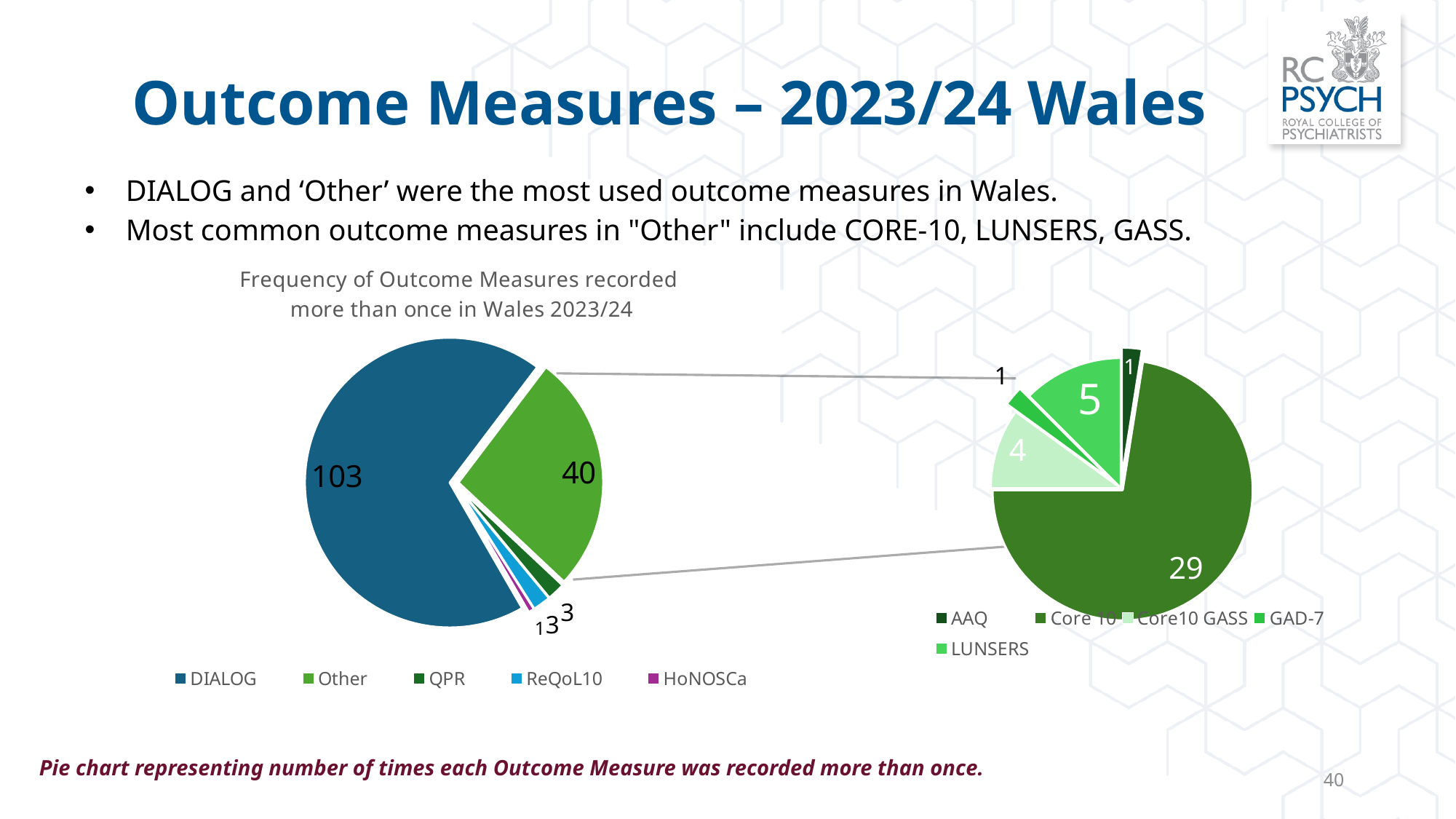
What is the value for DIALOG in the pie chart? 103 What is the value for Other in the pie chart? 40 In the breakdown of the 'Other' slice, what is the value for Core 10? 29 What type of chart is shown on the slide? Pie chart Which is larger, the value for Core 10 or the value for LUNSERS? Core 10 In the breakdown of the 'Other' slice, what is the value for Core10 GASS? 4 How many entries does the legend of the main pie chart list? 5 What is the value for HoNOSCa in the pie chart? 1 Which outcome measure has the smallest slice in the main pie chart? HoNOSCa In the breakdown of the 'Other' slice, what is the value for LUNSERS? 5 What is the difference between the DIALOG value and the Other value? 63 Which outcome measure has the largest slice in the main pie chart? DIALOG